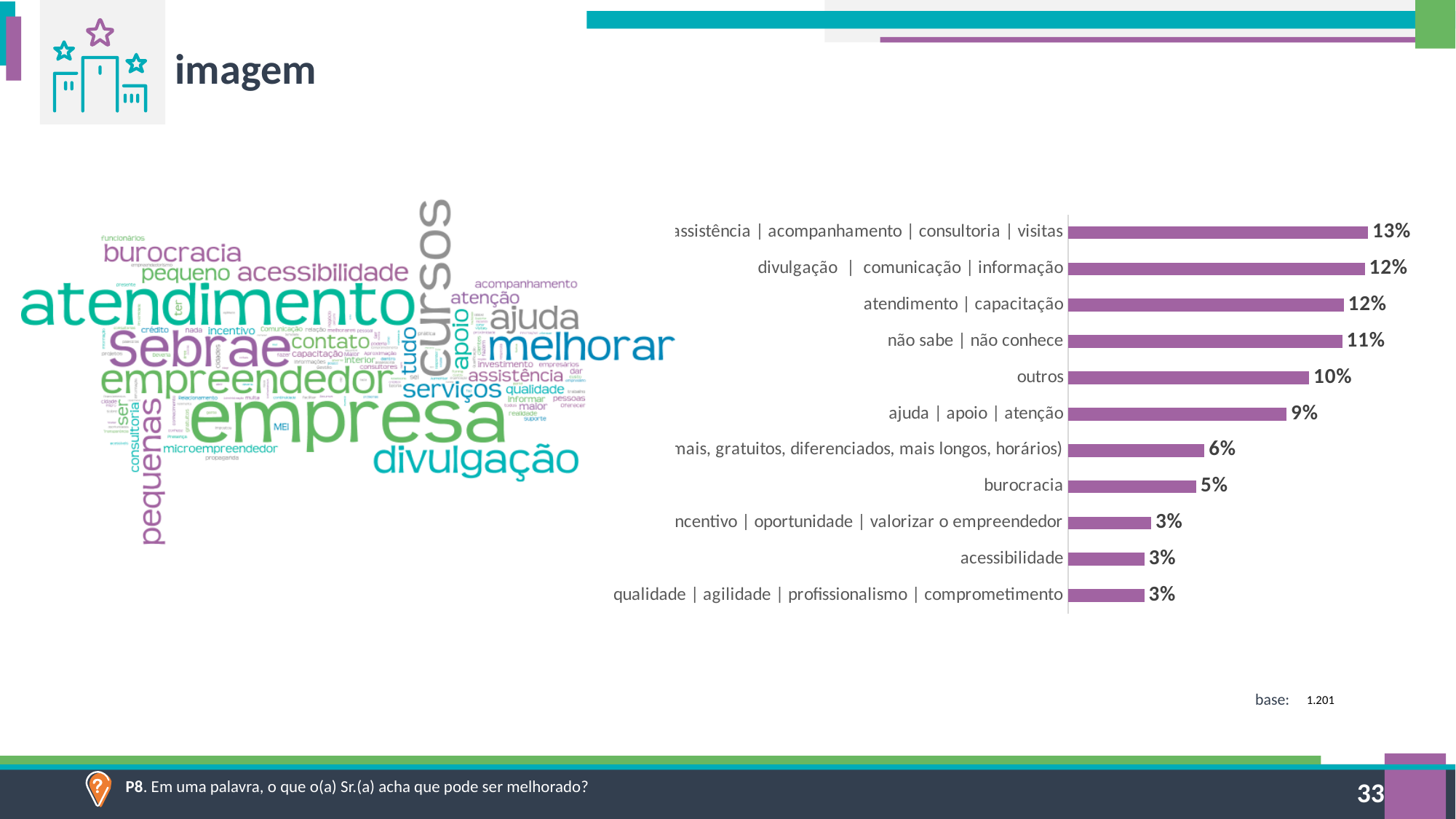
What is the difference between the values for "não sabe | não conhece" and "ajuda | apoio | atenção" in the bar chart? 2% What is the base (number of respondents) shown below the bar chart? 1.201 What percentage is shown for "outros" in the bar chart? 10% What percentage is shown for "não sabe | não conhece" in the bar chart? 11% What percentage is shown for "burocracia" in the bar chart? 5% How many bars are shown in the bar chart? 11 Which is larger in the bar chart: "atendimento | capacitação" or "acessibilidade"? atendimento | capacitação What kind of chart is shown on the right side of the slide? bar chart What percentage is shown for "ajuda | apoio | atenção" in the bar chart? 9% What is the difference between the values for "outros" and "burocracia" in the bar chart? 5% What is the value of the top bar in the bar chart? 13% Which category has the highest value in the bar chart? assistência | acompanhamento | consultoria | visitas